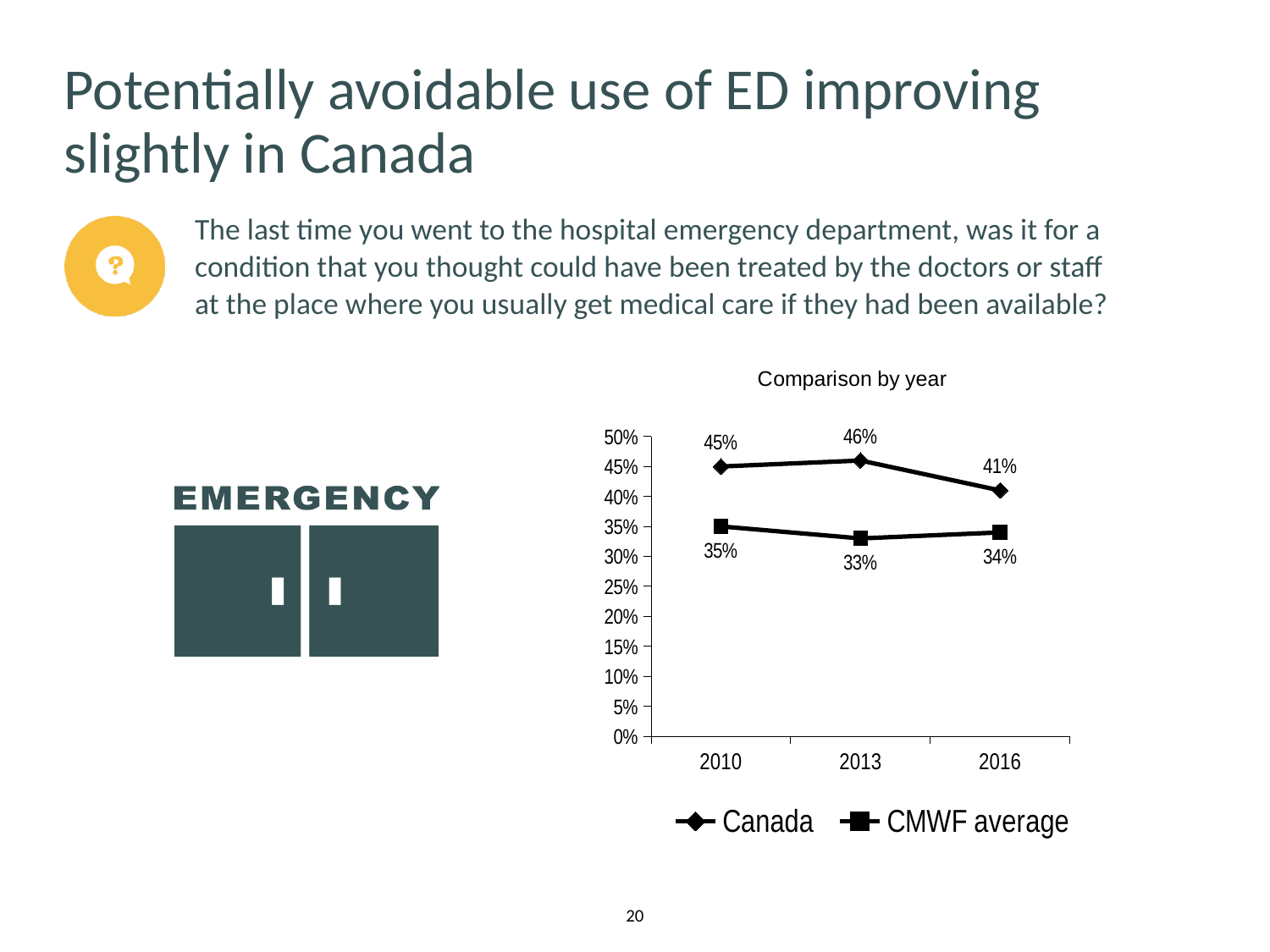
Is the Canada value in 2013 greater or less than 40%? greater How many series does the legend list? 2 In which year is the Canada value highest? 2013 What is the title of the chart? Comparison by year What is the value for Canada in 2016? 41% Which is larger in 2010, the Canada value or the CMWF average value? Canada What is the value for Canada in 2010? 45% What kind of chart is shown? line chart How many years are shown on the x axis? 3 In which year is the CMWF average value lowest? 2013 What is the CMWF average value in 2013? 33% What is the difference between the Canada value and the CMWF average value in 2016? 7%